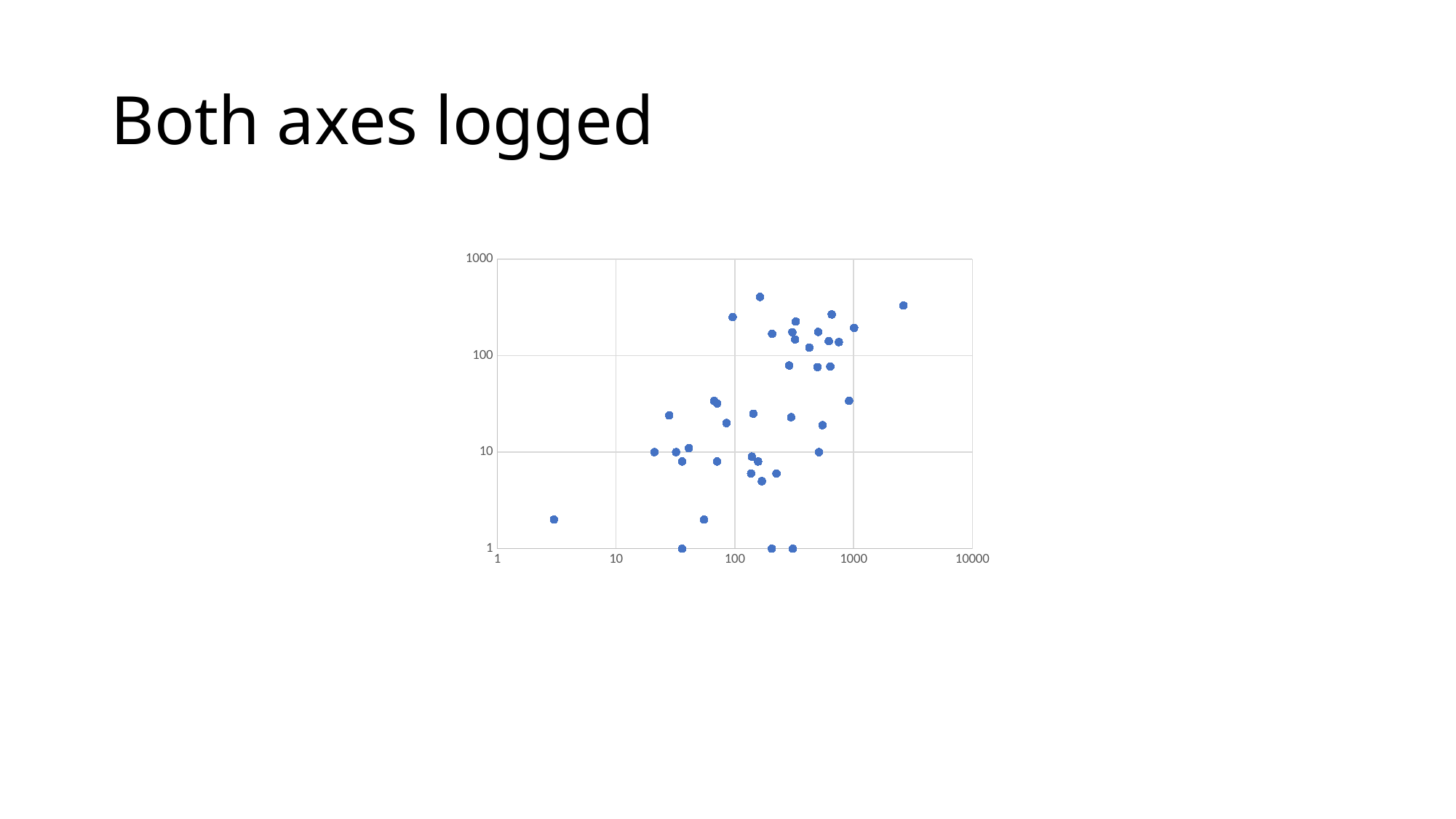
Do the plotted y values generally rise or fall as the x values increase? rise What is the highest tick label shown on the y axis? 1000 What kind of chart is shown on the slide? scatter plot What is the highest tick label shown on the x axis? 10000